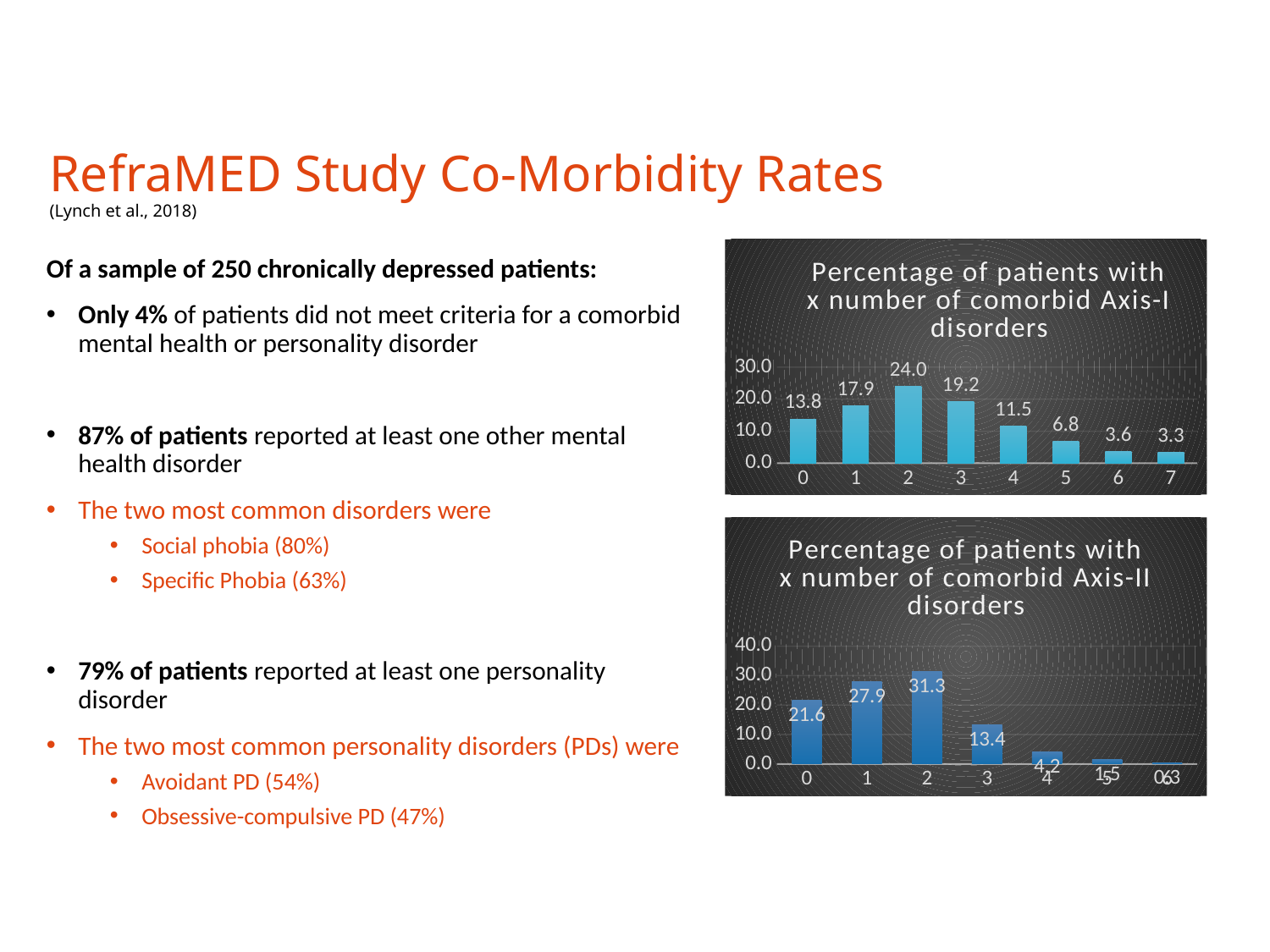
In the 'Percentage of patients with x number of comorbid Axis-I disorders' chart, do the values rise or fall from 3 disorders to 7 disorders? fall In the 'Percentage of patients with x number of comorbid Axis-II disorders' chart, what is the value for 3 disorders? 13.4 In the 'Percentage of patients with x number of comorbid Axis-I disorders' chart, which number of disorders has the highest percentage? 2 In the 'Percentage of patients with x number of comorbid Axis-I disorders' chart, how many categories are shown on the x axis? 8 What type of chart is the 'Percentage of patients with x number of comorbid Axis-II disorders' chart? bar chart In the 'Percentage of patients with x number of comorbid Axis-I disorders' chart, what is the value for 0 disorders? 13.8 In the 'Percentage of patients with x number of comorbid Axis-I disorders' chart, what is the value for 2 disorders? 24.0 In the 'Percentage of patients with x number of comorbid Axis-II disorders' chart, is the value for 2 disorders greater or less than 30.0? greater In the 'Percentage of patients with x number of comorbid Axis-I disorders' chart, which number of disorders has the lowest percentage? 7 In the 'Percentage of patients with x number of comorbid Axis-I disorders' chart, what is the difference between the values for 2 and 3 disorders? 4.8 In the 'Percentage of patients with x number of comorbid Axis-II disorders' chart, what is the value for 2 disorders? 31.3 In the 'Percentage of patients with x number of comorbid Axis-II disorders' chart, which is larger, the value for 0 disorders or the value for 1 disorder? 1 disorder